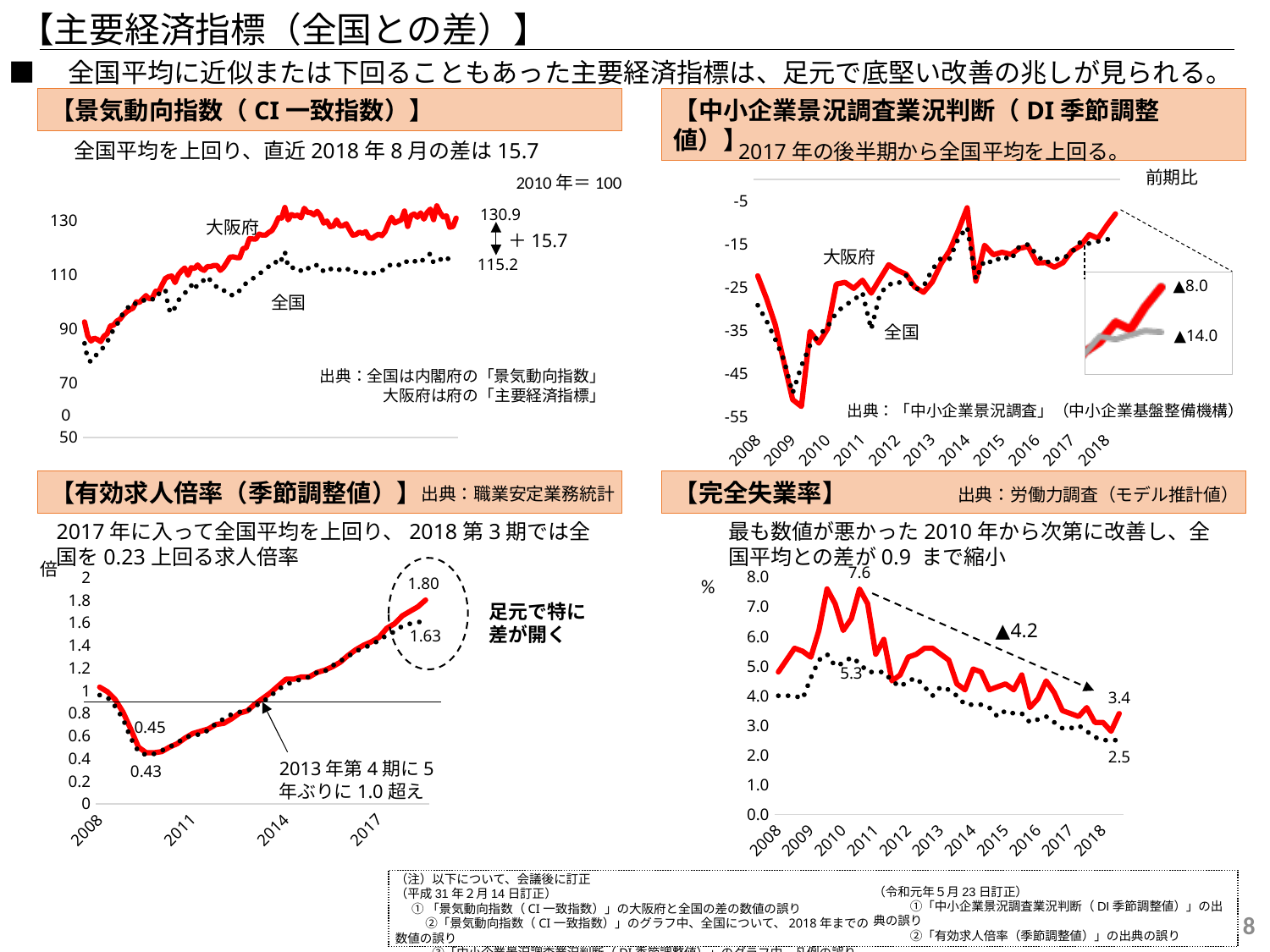
In the 景気動向指数（CI一致指数） chart, what is the latest value labelled for 全国? 115.2 In the 景気動向指数（CI一致指数） chart, what is the difference between the latest 大阪府 value (130.9) and the latest 全国 value (115.2)? 15.7 In the 景気動向指数（CI一致指数） chart, which series is higher at the right end, 大阪府 or 全国? 大阪府 In the 景気動向指数（CI一致指数） chart, what is the latest value labelled for 大阪府? 130.9 In the 有効求人倍率（季節調整値） chart, what is the latest value labelled for the 大阪府 (red) line? 1.80 In the 有効求人倍率（季節調整値） chart, what is the lowest value labelled on the 大阪府 (red) line? 0.45 How many series are plotted in the 中小企業景況調査業況判断 chart? 2 In the 完全失業率 chart, what is the peak value labelled for the 大阪府 (red) line? 7.6 In the 中小企業景況調査業況判断 chart, is the lowest value of the 大阪府 line around 2009 greater or less than -45? less What kind of chart is the 景気動向指数（CI一致指数） chart? line chart In the 完全失業率 chart, what is the difference between the 大阪府 peak value (7.6) and its latest value (3.4)? 4.2 In the 中小企業景況調査業況判断 chart, what value is labelled for the 大阪府 line in the inset box? ▲8.0